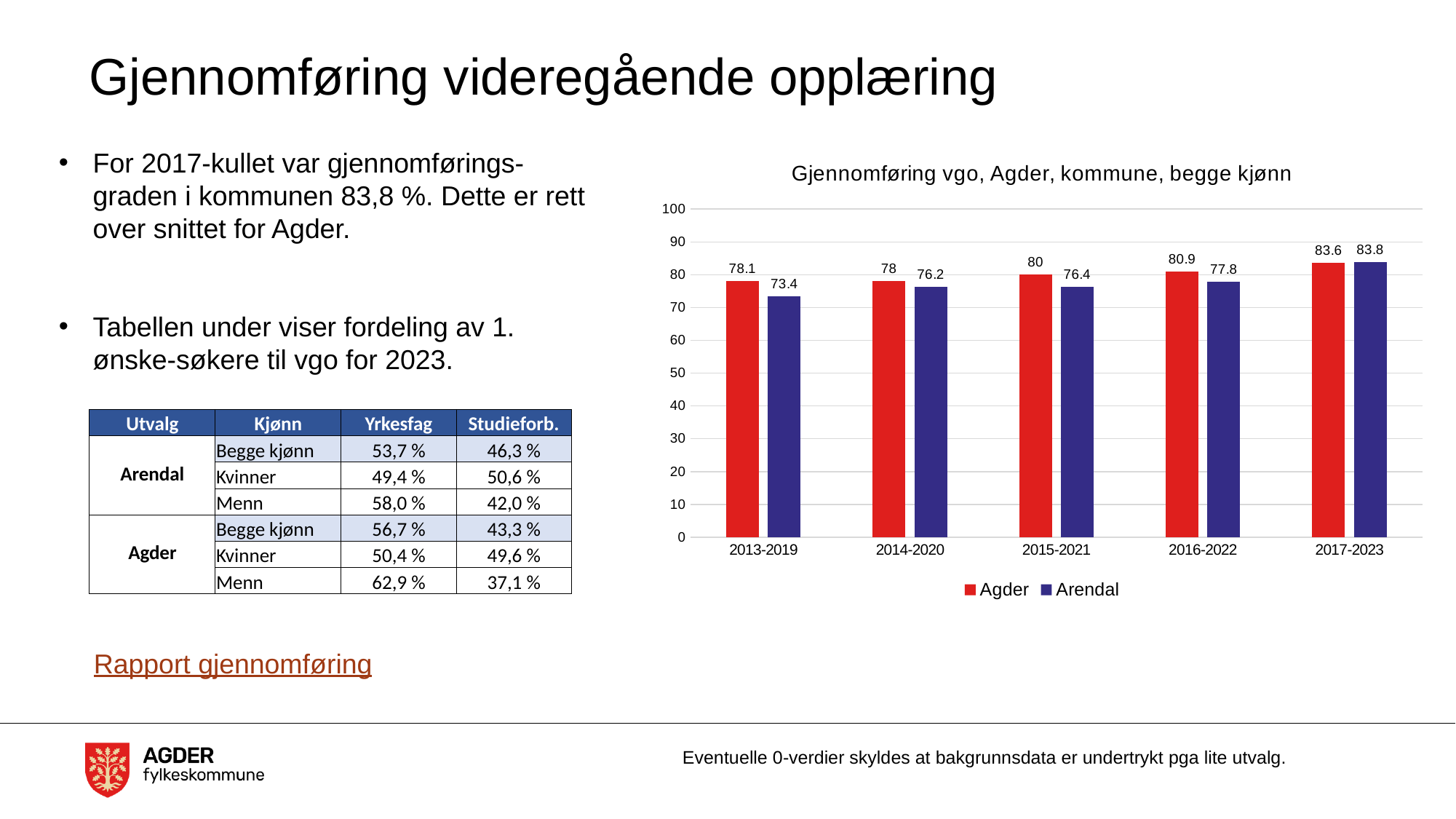
What is the value for Arendal in 2017-2023? 83.8 What kind of chart is shown? bar chart How many series does the legend list? 2 How many periods are shown on the x axis? 5 What is the value for Agder in 2013-2019? 78.1 What is the difference between Agder and Arendal in 2013-2019? 4.7 Do the values for Arendal rise or fall from 2013-2019 to 2017-2023? rise Which is larger in 2016-2022, Agder or Arendal? Agder Which period has the highest value for Arendal? 2017-2023 Which period has the lowest value for Arendal? 2013-2019 Is the value for Arendal in 2014-2020 greater or less than 80? less What is the value for Arendal in 2015-2021? 76.4